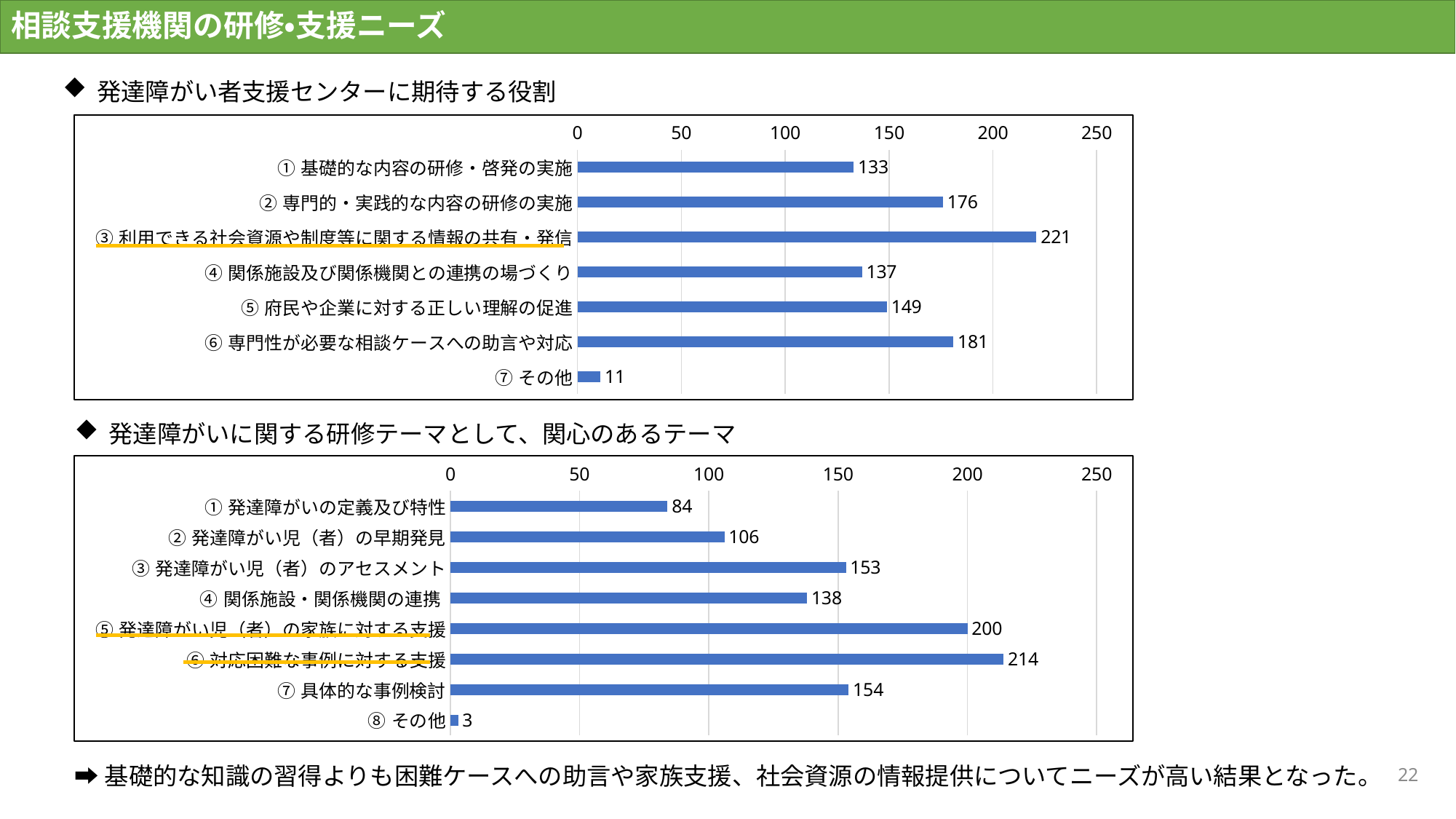
In the bottom chart (発達障がいに関する研修テーマとして、関心のあるテーマ), which category has the highest value? ⑥ 対応困難な事例に対する支援 In the top chart (発達障がい者支援センターに期待する役割), how many categories are shown? 7 In the bottom chart (発達障がいに関する研修テーマとして、関心のあるテーマ), what is the difference between ⑤ 発達障がい児（者）の家族に対する支援 and ① 発達障がいの定義及び特性? 116 In the bottom chart (発達障がいに関する研修テーマとして、関心のあるテーマ), how many categories are shown? 8 In the top chart (発達障がい者支援センターに期待する役割), which category has the lowest value? ⑦ その他 What type of chart is the top chart (発達障がい者支援センターに期待する役割)? Bar chart In the top chart (発達障がい者支援センターに期待する役割), what is the value for ③ 利用できる社会資源や制度等に関する情報の共有・発信? 221 In the top chart (発達障がい者支援センターに期待する役割), what is the difference between ② 専門的・実践的な内容の研修の実施 and ① 基礎的な内容の研修・啓発の実施? 43 In the bottom chart (発達障がいに関する研修テーマとして、関心のあるテーマ), what is the value for ⑥ 対応困難な事例に対する支援? 214 In the bottom chart (発達障がいに関する研修テーマとして、関心のあるテーマ), which is larger: ② 発達障がい児（者）の早期発見 or ④ 関係施設・関係機関の連携? ④ 関係施設・関係機関の連携 In the top chart (発達障がい者支援センターに期待する役割), what is the value for ⑤ 府民や企業に対する正しい理解の促進? 149 In the top chart (発達障がい者支援センターに期待する役割), is the value for ⑥ 専門性が必要な相談ケースへの助言や対応 greater or less than 150? greater